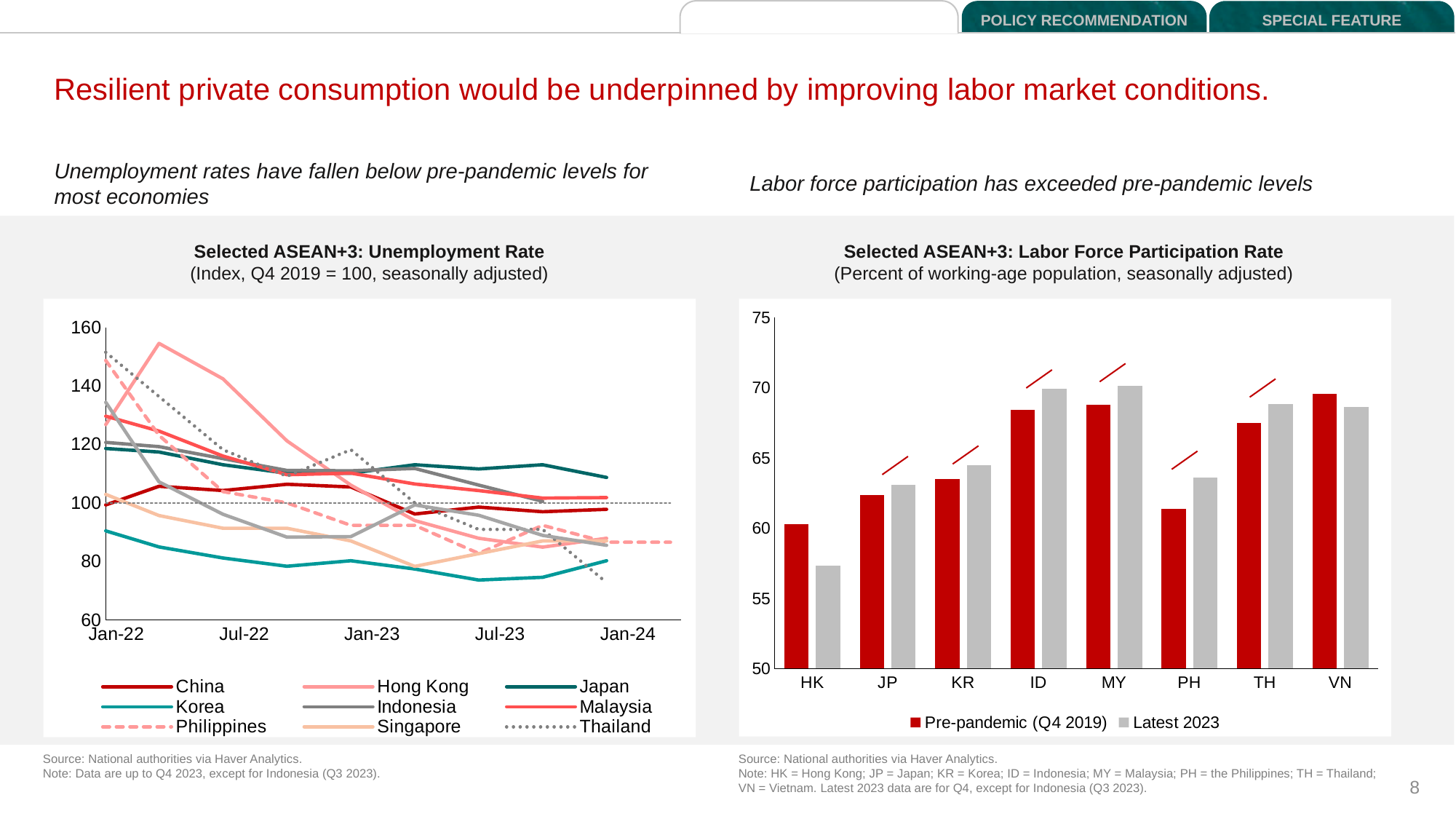
What kind of chart is the 'Selected ASEAN+3: Unemployment Rate' chart on the left? line chart How many series does the legend of the 'Selected ASEAN+3: Labor Force Participation Rate' chart list? 2 In the 'Selected ASEAN+3: Unemployment Rate' chart, does the Hong Kong line rise or fall overall from Jan-22 to Jan-24? fall How many economies does the legend of the 'Selected ASEAN+3: Unemployment Rate' chart list? 9 In the 'Selected ASEAN+3: Labor Force Participation Rate' chart, is the Latest 2023 value for HK greater or less than 60? less How many economies are shown on the x axis of the 'Selected ASEAN+3: Labor Force Participation Rate' chart? 8 In the 'Selected ASEAN+3: Labor Force Participation Rate' chart, for PH, which is larger: the Pre-pandemic (Q4 2019) value or the Latest 2023 value? Latest 2023 In the 'Selected ASEAN+3: Labor Force Participation Rate' chart, is the Pre-pandemic (Q4 2019) value for PH greater or less than 65? less What kind of chart is the 'Selected ASEAN+3: Labor Force Participation Rate' chart on the right? bar chart In the 'Selected ASEAN+3: Labor Force Participation Rate' chart, which economy has the lowest Latest 2023 value? HK In the 'Selected ASEAN+3: Labor Force Participation Rate' chart, which economy has the highest Pre-pandemic (Q4 2019) value? VN In the 'Selected ASEAN+3: Unemployment Rate' chart, which economy has the lowest value at Jan-24? Thailand